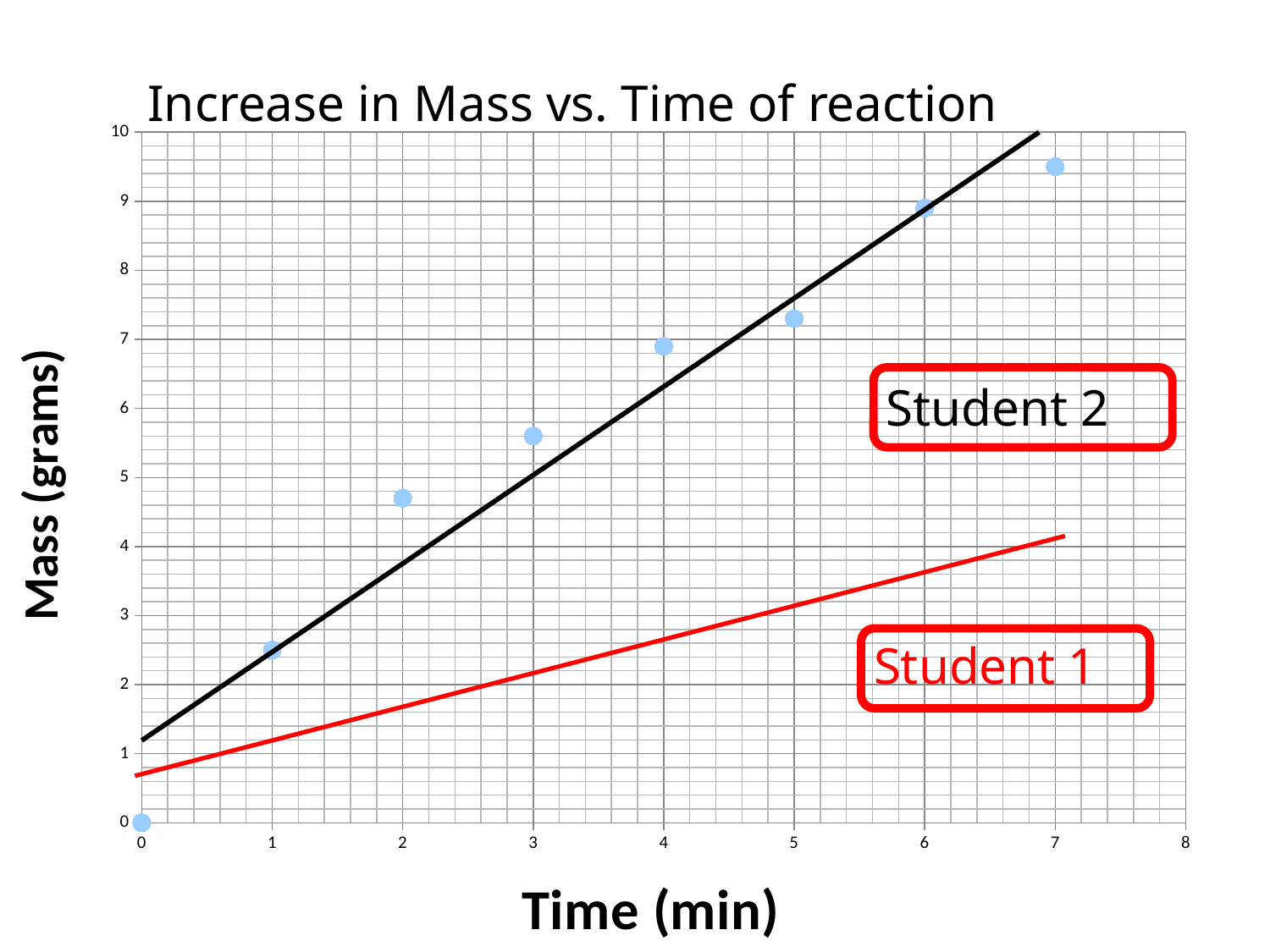
Which student's line is drawn in red? Student 1 What is the title of the chart? Increase in Mass vs. Time of reaction Is the plotted mass at 5 min greater or less than 8 grams? less Is the plotted mass at 3 min greater or less than 5 grams? greater At which time is the plotted mass lowest? 0 min What kind of chart is shown on the slide? scatter chart Is the plotted mass at 1 min greater or less than 2 grams? greater How many data points are plotted on the chart? 8 What is the mass value plotted at time 0 min? 0 Do the plotted mass values rise or fall as time increases? rise At which time is the plotted mass highest? 7 min